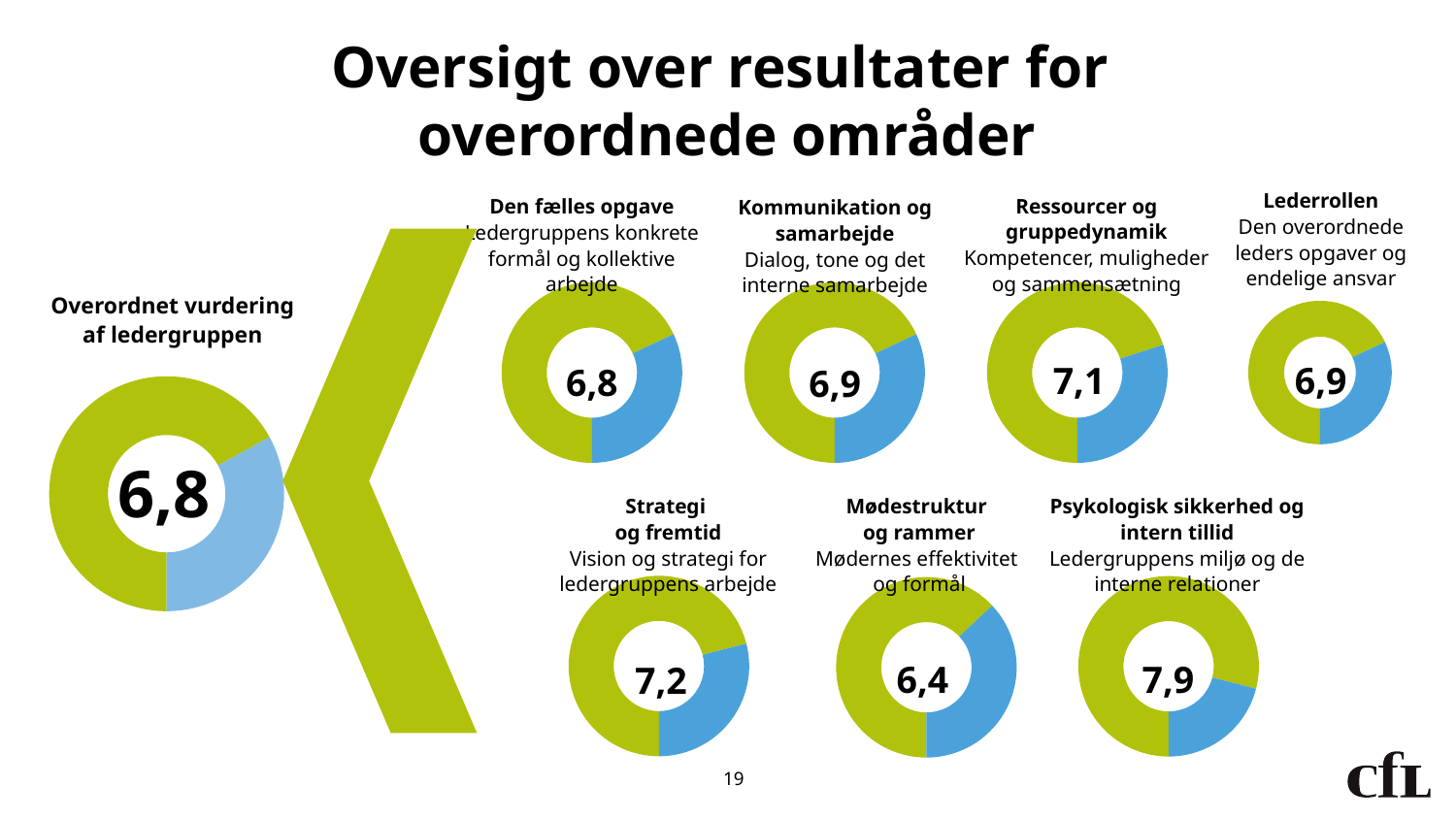
What value is shown in the 'Kommunikation og samarbejde' donut chart? 6,9 What value is shown in the 'Lederrollen' donut chart? 6,9 What value is shown in the 'Ressourcer og gruppedynamik' donut chart? 7,1 Which area has the lowest value among the donut charts on the slide? Mødestruktur og rammer What value is shown in the 'Psykologisk sikkerhed og intern tillid' donut chart? 7,9 Which area has the highest value among the donut charts on the slide? Psykologisk sikkerhed og intern tillid What value is shown in the centre of the 'Overordnet vurdering af ledergruppen' donut chart? 6,8 How many donut charts are shown on the slide? 8 What is the difference between the value for 'Psykologisk sikkerhed og intern tillid' and the value for 'Mødestruktur og rammer'? 1,5 What value is shown in the 'Mødestruktur og rammer' donut chart? 6,4 What value is shown in the 'Strategi og fremtid' donut chart? 7,2 What value is shown in the 'Den fælles opgave' donut chart? 6,8